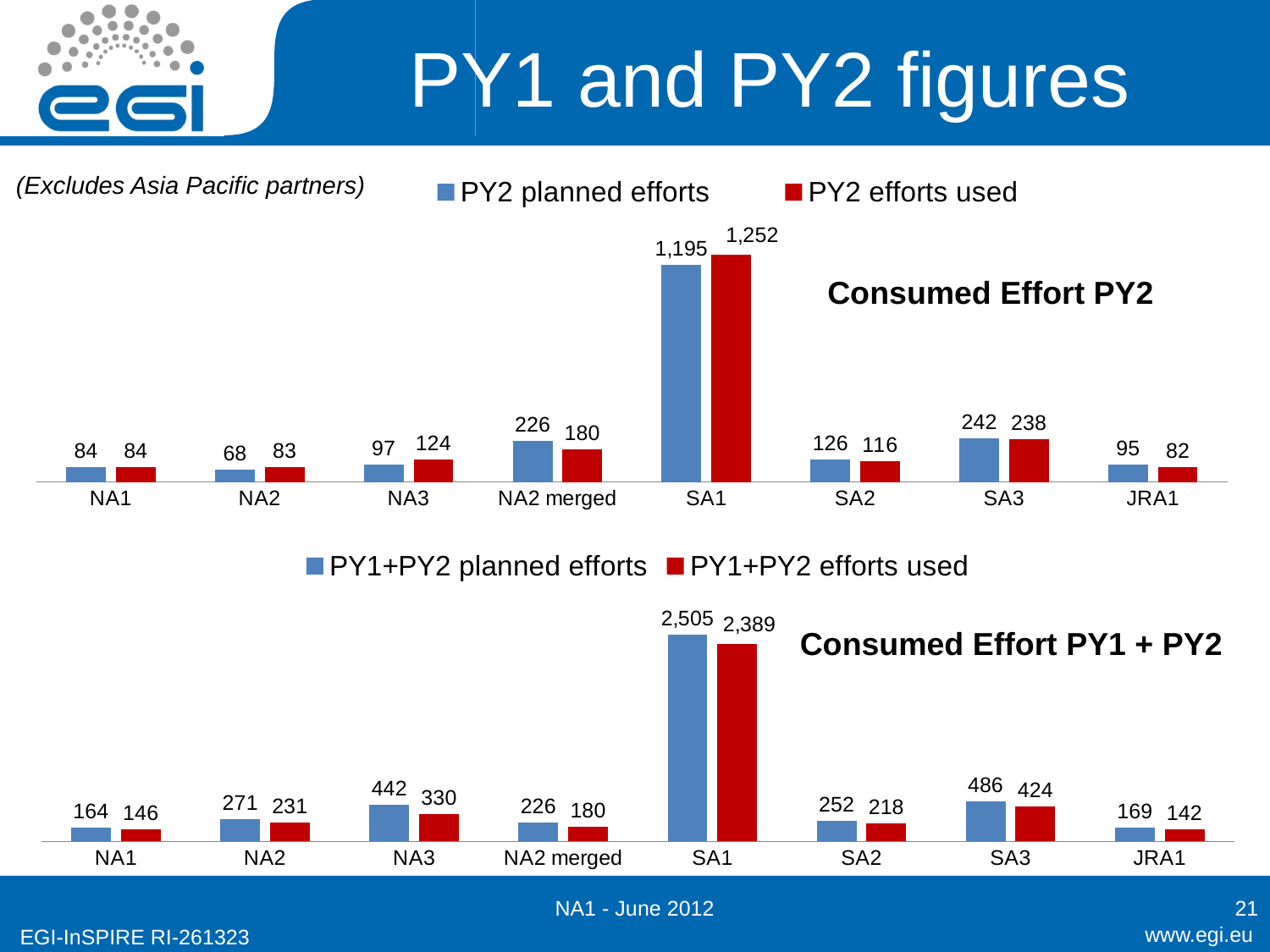
In the Consumed Effort PY2 chart, which category has the lowest PY2 planned efforts? NA2 In the Consumed Effort PY2 chart, what is the PY2 planned efforts value for SA1? 1,195 In the Consumed Effort PY1 + PY2 chart, what is the PY1+PY2 efforts used value for SA3? 424 In the Consumed Effort PY1 + PY2 chart, which is larger for SA1: PY1+PY2 planned efforts or PY1+PY2 efforts used? PY1+PY2 planned efforts In the Consumed Effort PY1 + PY2 chart, what is the difference between PY1+PY2 planned efforts and PY1+PY2 efforts used for SA1? 116 In the Consumed Effort PY2 chart, which category has the highest PY2 efforts used? SA1 In the Consumed Effort PY2 chart, what is the PY2 efforts used value for NA3? 124 How many series does the legend of the Consumed Effort PY1 + PY2 chart list? 2 What kind of chart is the Consumed Effort PY2 chart? Bar chart In the Consumed Effort PY2 chart, what is the difference between PY2 planned efforts and PY2 efforts used for NA2 merged? 46 In the Consumed Effort PY2 chart, how many categories are shown on the x axis? 8 In the Consumed Effort PY1 + PY2 chart, what is the PY1+PY2 planned efforts value for NA3? 442